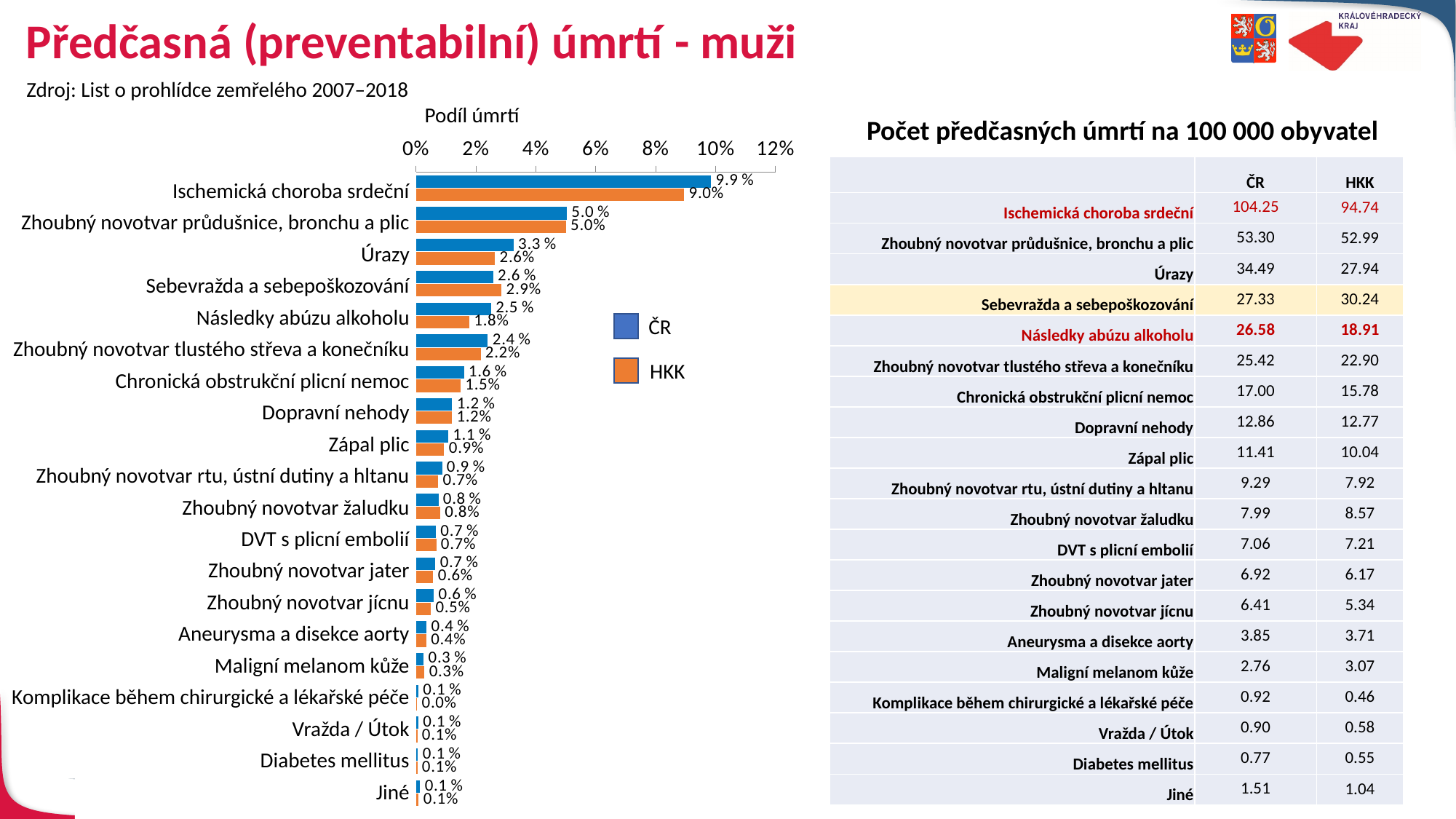
In the bar chart, what is the difference between the ČR and HKK values for Úrazy? 0.7 % In the bar chart, what is the ČR value for Ischemická choroba srdeční? 9.9 % How many series does the legend of the bar chart list? 2 In the bar chart, what is the HKK value for Sebevražda a sebepoškozování? 2.9% Which category has the highest ČR value in the bar chart? Ischemická choroba srdeční In the bar chart, which is larger for Sebevražda a sebepoškozování: the ČR value or the HKK value? HKK In the bar chart, what is the ČR value for Úrazy? 3.3 % In the bar chart, is the ČR value for Zhoubný novotvar průdušnice, bronchu a plic greater or less than 4%? greater What kind of chart is shown on the left of the slide? bar chart What is the title of the bar chart? Podíl úmrtí How many categories are plotted in the bar chart? 20 In the bar chart, what is the HKK value for Ischemická choroba srdeční? 9.0%